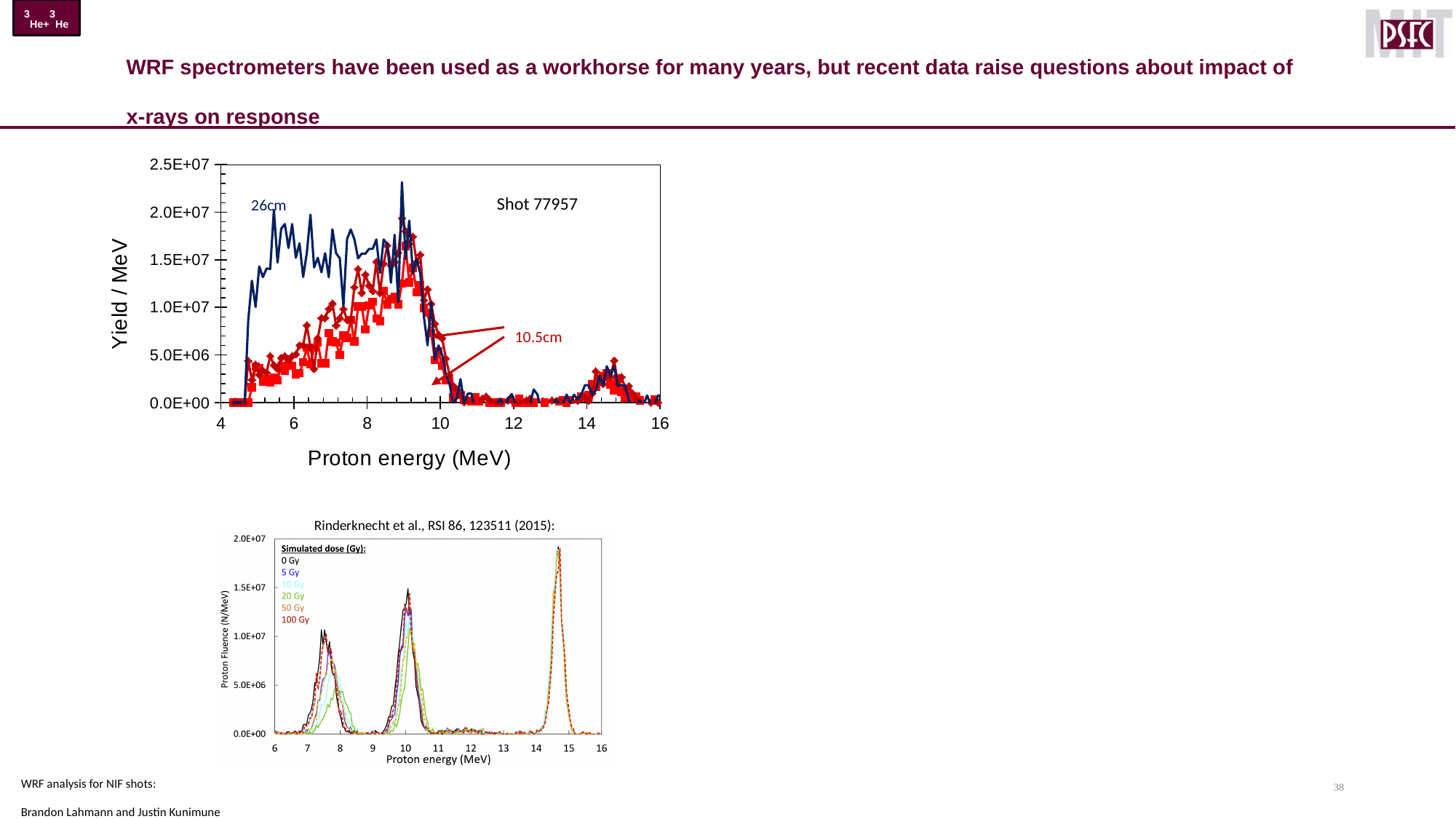
In the bottom chart (Rinderknecht et al.), is the peak proton fluence near 14.7 MeV greater or less than 1.5E+07? greater In the top chart (Shot 77957), is the yield of the 10.5cm series at 6 MeV greater or less than 1.0E+07? less In the top chart (Shot 77957), what is the highest value shown on the y axis? 2.5E+07 How many simulated dose entries does the legend of the bottom chart (Rinderknecht et al.) list? 6 In the top chart (Shot 77957), is the peak yield of the 26cm series near 9 MeV greater or less than 2.0E+07? greater In the bottom chart (Rinderknecht et al.), which peak is higher, the one near 7.5 MeV or the one near 10 MeV? the one near 10 MeV In the top chart (Shot 77957), which series has the larger yield at a proton energy of 6 MeV, 26cm or 10.5cm? 26cm In the top chart (Shot 77957), do the yields rise or fall as proton energy goes from 9 MeV to 11 MeV? fall In the top chart (Shot 77957), what is the label on the x axis? Proton energy (MeV) How many distinct peaks are visible in the bottom chart (Rinderknecht et al.)? 3 What kind of chart is the top chart labelled Shot 77957? line chart